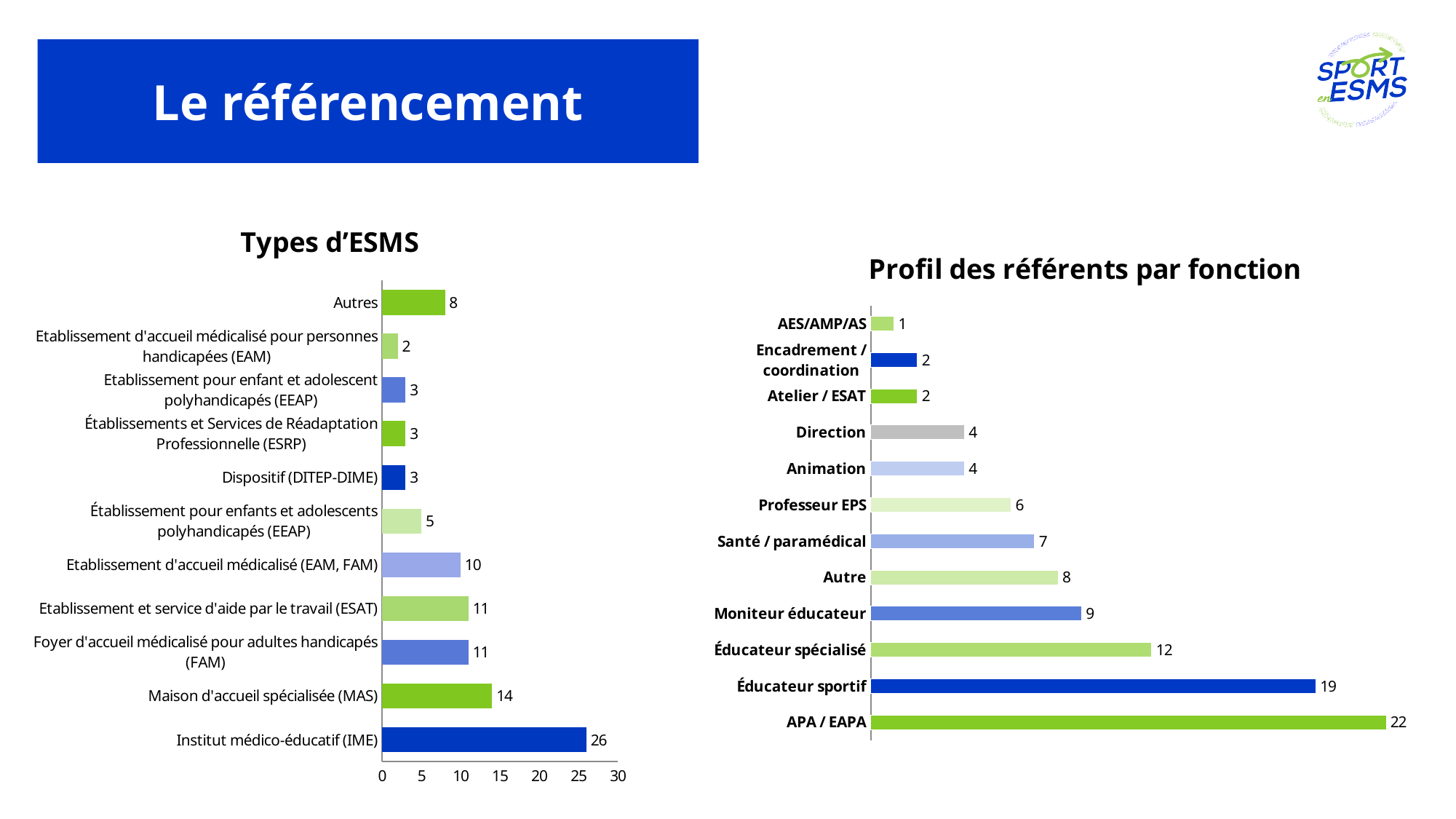
In the 'Profil des référents par fonction' chart, which is larger: Moniteur éducateur or Santé / paramédical? Moniteur éducateur In the 'Types d'ESMS' chart, what is the difference between Institut médico-éducatif (IME) and Maison d'accueil spécialisée (MAS)? 12 In the 'Types d'ESMS' chart, how many categories are shown? 11 In the 'Profil des référents par fonction' chart, which function has the lowest value? AES/AMP/AS In the 'Profil des référents par fonction' chart, what is the difference between APA / EAPA and Éducateur spécialisé? 10 In the 'Types d'ESMS' chart, which category has the lowest value? Etablissement d'accueil médicalisé pour personnes handicapées (EAM) In the 'Profil des référents par fonction' chart, what is the value for Éducateur sportif? 19 In the 'Types d'ESMS' chart, what is the value for Institut médico-éducatif (IME)? 26 In the 'Types d'ESMS' chart, what is the value for Maison d'accueil spécialisée (MAS)? 14 In the 'Types d'ESMS' chart, is the value for Autres greater or less than 5? greater What type of chart is 'Profil des référents par fonction'? Bar chart In the 'Profil des référents par fonction' chart, which function has the highest value? APA / EAPA